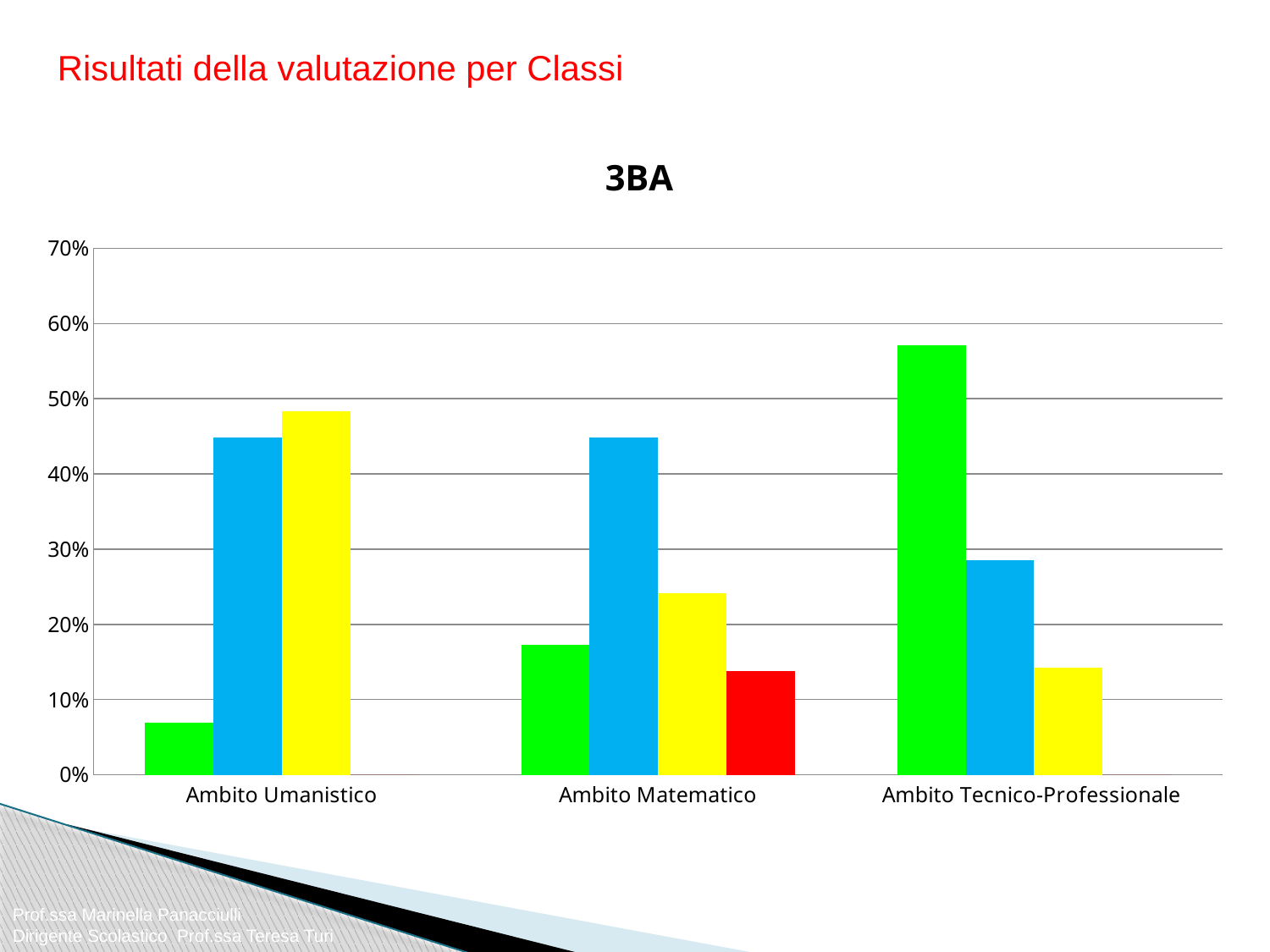
In Ambito Tecnico-Professionale, which is larger, the green bar or the blue bar? the green bar Is the value of the yellow bar for Ambito Tecnico-Professionale greater or less than 20%? less Is the value of the green bar for Ambito Umanistico greater or less than 10%? less Which category contains a red bar? Ambito Matematico Is the value of the green bar for Ambito Tecnico-Professionale greater or less than 50%? greater What is the title of the chart? 3BA Which category has the tallest bar in the chart? Ambito Tecnico-Professionale How many categories are shown on the x axis of the chart? 3 What kind of chart is shown on the slide? bar chart In Ambito Umanistico, which is larger, the green bar or the blue bar? the blue bar How many bars are plotted for Ambito Matematico? 4